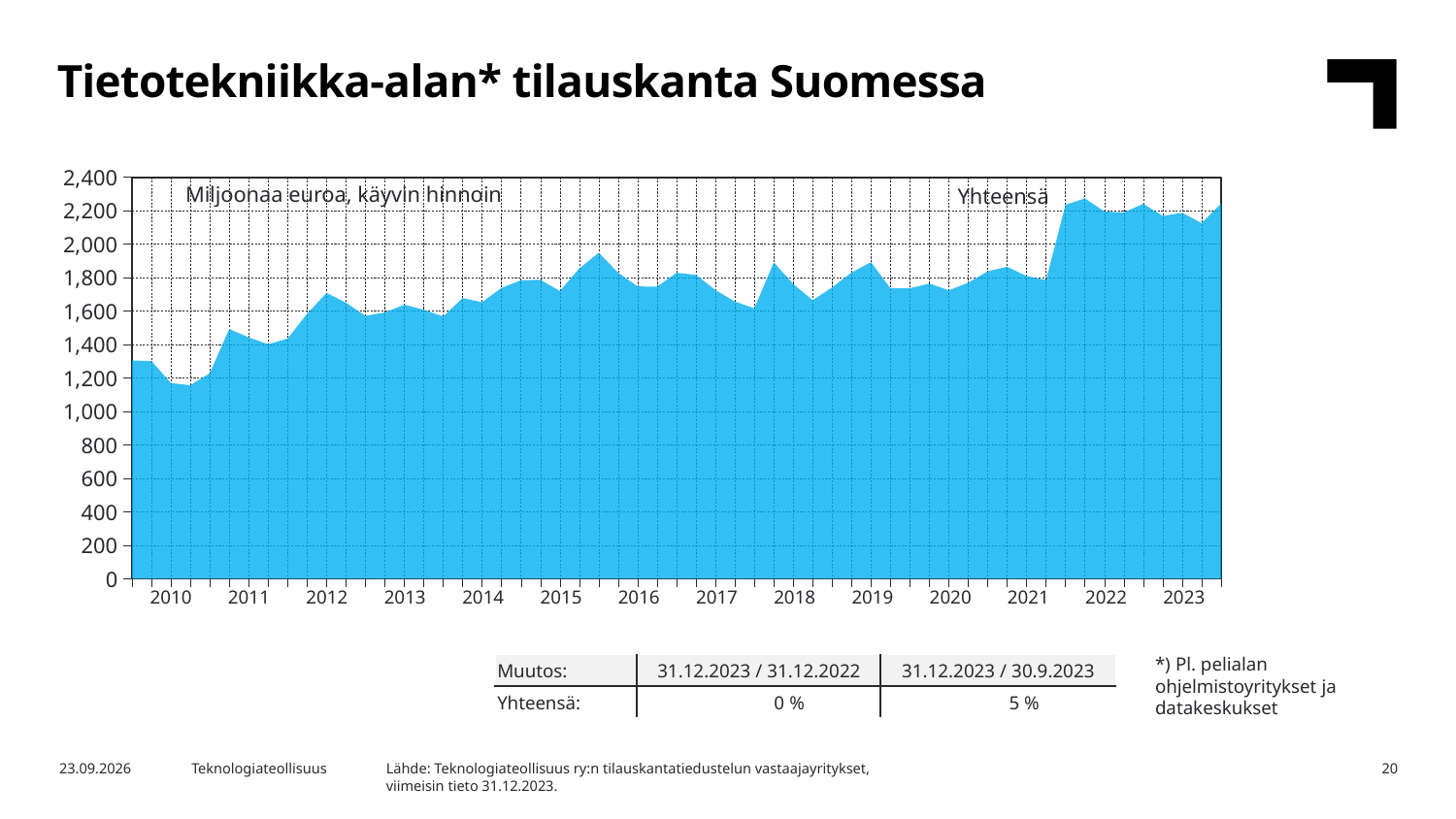
Overall, do the values rise or fall from 2010 to 2023? rise Which year has the lowest values on the chart? 2010 Is the highest value in 2015 greater or less than 2,000? less What kind of chart is shown on the slide? area chart What is the title of the chart on the slide? Tietotekniikka-alan* tilauskanta Suomessa How many years are labelled on the x axis of the chart? 14 Is the value in 2016 greater or less than 1,600? greater Is the value at the start of 2010 greater or less than 1,000? greater In the table below the chart, what is the change (Muutos) for Yhteensä between 31.12.2023 and 30.9.2023? 5 % Which is larger, the value in 2013 or the value in 2022? 2022 What unit is stated in the chart's label at the top left of the plot area? Miljoonaa euroa, käyvin hinnoin